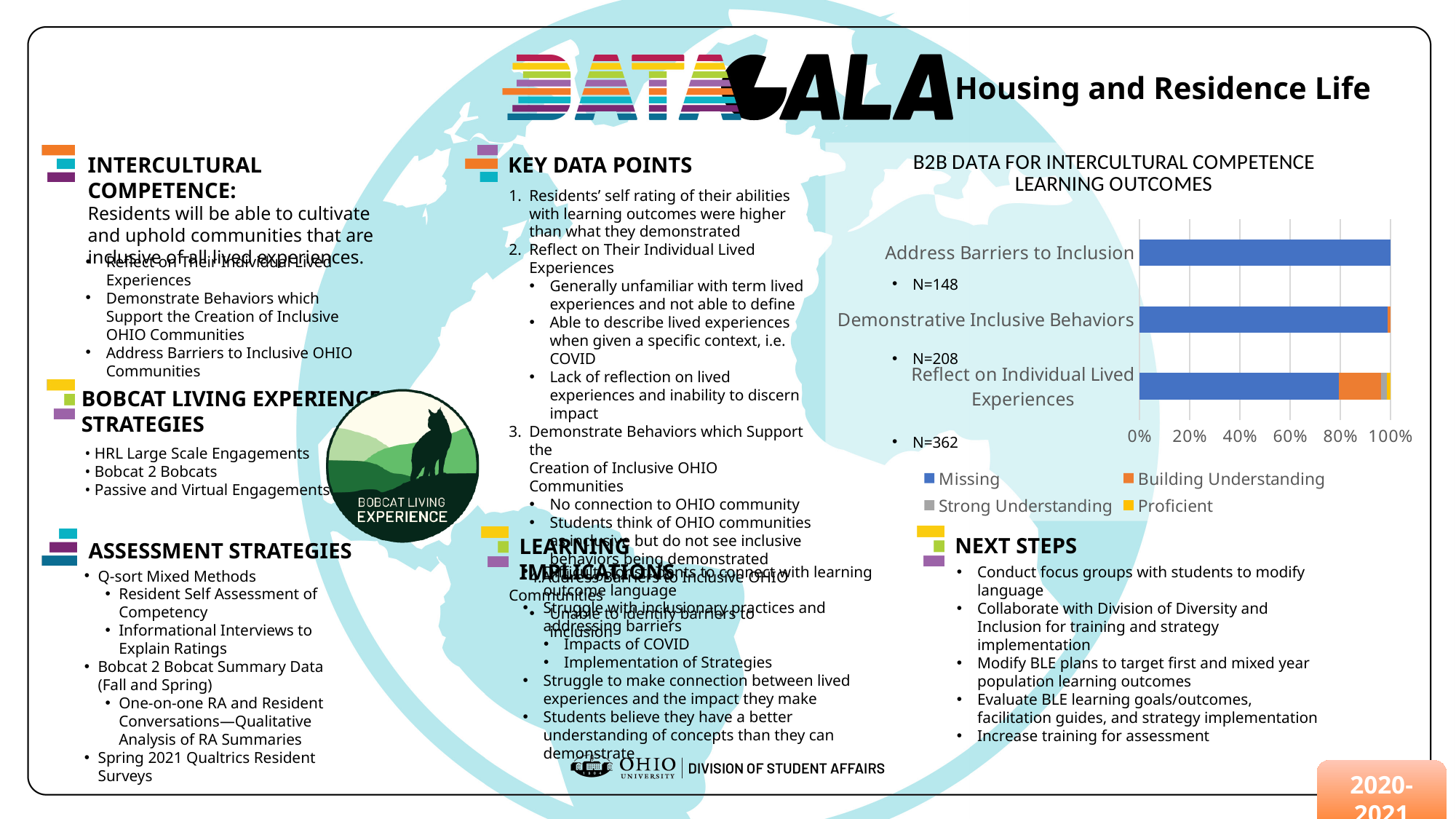
Is the Missing share larger for Address Barriers to Inclusion or for Reflect on Individual Lived Experiences? Address Barriers to Inclusion Which category has the largest Building Understanding share? Reflect on Individual Lived Experiences Is the Building Understanding share for Reflect on Individual Lived Experiences greater or less than 40%? less How many series does the chart legend list? 4 What is the title of the chart? B2B DATA FOR INTERCULTURAL COMPETENCE LEARNING OUTCOMES Which series is shown in blue in the chart? Missing How many categories are plotted on the chart? 3 What kind of chart is shown on the slide? Stacked bar chart What is the highest value shown on the chart's x axis? 100% Is the Missing share for Demonstrative Inclusive Behaviors greater or less than 80%? greater Is the Missing share for Address Barriers to Inclusion greater or less than 80%? greater Which category has the smallest Missing share? Reflect on Individual Lived Experiences